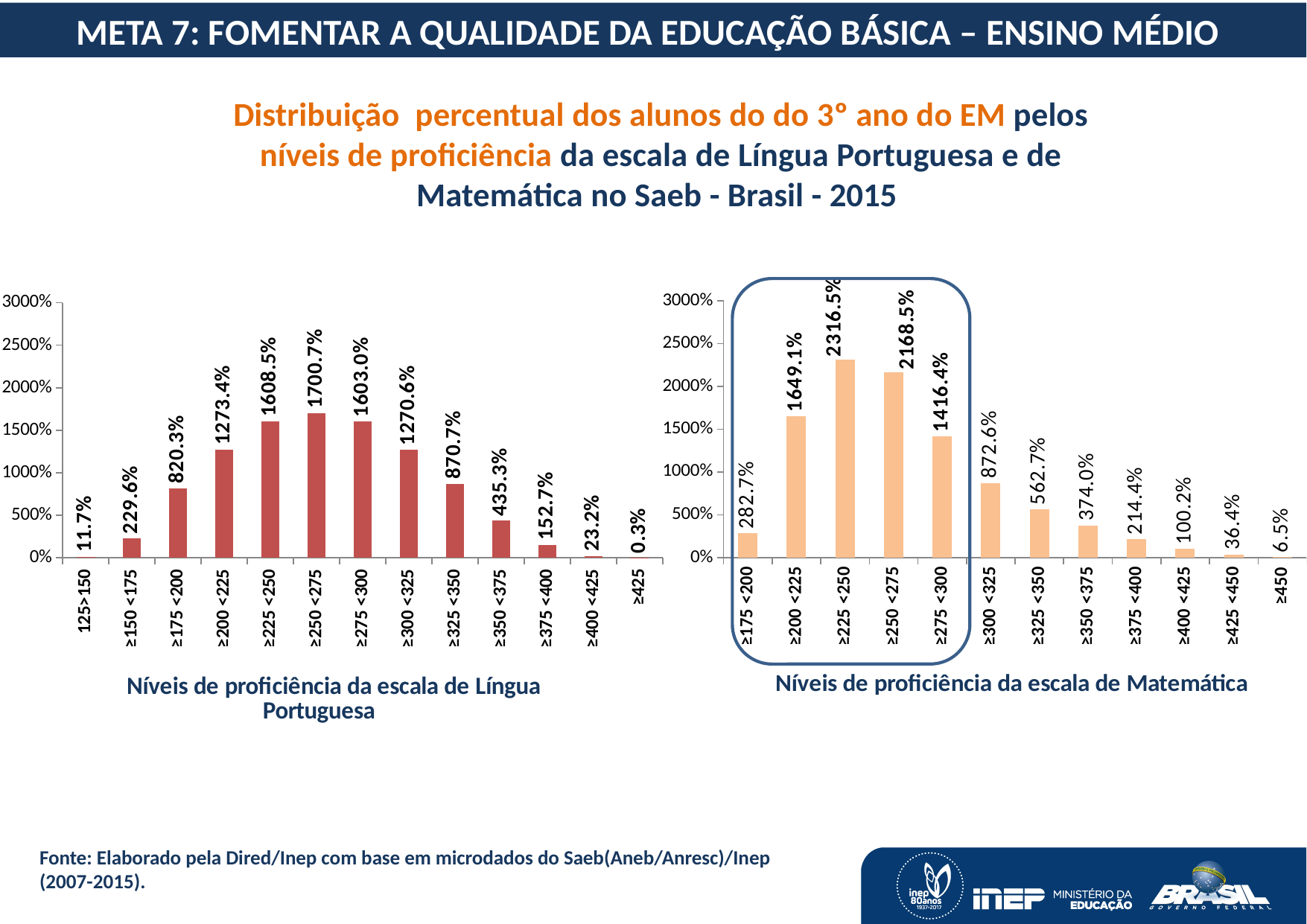
In the Língua Portuguesa chart, what is the difference between the values for ≥225 <250 and ≥200 <225? 335.1% In the Língua Portuguesa chart, what is the value for the ≥250 <275 level? 1700.7% In the Matemática chart, do the values rise or fall from ≥225 <250 to ≥450? fall In the Matemática chart, is the value for ≥300 <325 greater or less than 1000%? less In the Matemática chart, what is the value for the ≥450 level? 6.5% In the Matemática chart, what is the value for the ≥225 <250 level? 2316.5% How many proficiency levels are shown on the x axis of the Língua Portuguesa chart? 13 What kind of chart is the Matemática chart? bar chart In the Língua Portuguesa chart, which proficiency level has the lowest value? ≥425 How many proficiency levels are shown on the x axis of the Matemática chart? 12 In the Matemática chart, which proficiency level has the highest value? ≥225 <250 In the Matemática chart, which is larger: the value for ≥200 <225 or the value for ≥275 <300? ≥200 <225